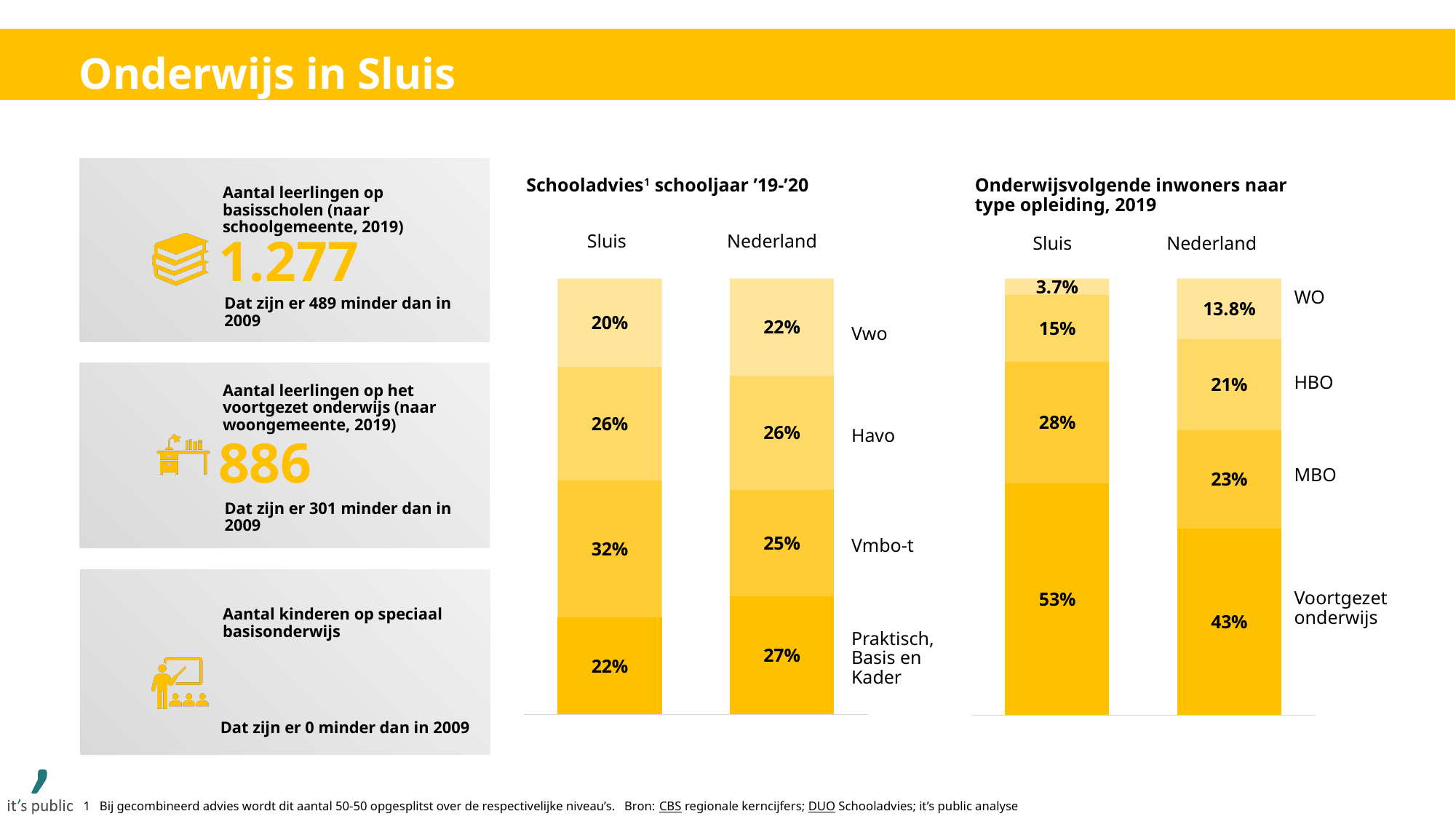
In the 'Onderwijsvolgende inwoners naar type opleiding, 2019' chart, what is the difference between the Voortgezet onderwijs share for Sluis and for Nederland? 10 percentage points What kind of chart is the 'Onderwijsvolgende inwoners naar type opleiding, 2019' chart? Stacked bar chart In the 'Schooladvies schooljaar '19-'20' chart, which segment is the largest in the Sluis bar? Vmbo-t In the 'Onderwijsvolgende inwoners naar type opleiding, 2019' chart, what is the WO share for Sluis? 3.7% In the 'Schooladvies schooljaar '19-'20' chart, what is the Vwo share for Nederland? 22% How many bars does the 'Schooladvies schooljaar '19-'20' chart show? 2 In the 'Onderwijsvolgende inwoners naar type opleiding, 2019' chart, what is the MBO share for Nederland? 23% In the 'Onderwijsvolgende inwoners naar type opleiding, 2019' chart, which segment is the smallest in the Nederland bar? WO In the 'Onderwijsvolgende inwoners naar type opleiding, 2019' chart, which is larger: the HBO share for Sluis or for Nederland? Nederland In the 'Schooladvies schooljaar '19-'20' chart, what is the difference between the Praktisch, Basis en Kader share for Nederland and for Sluis? 5 percentage points In the 'Schooladvies schooljaar '19-'20' chart, what is the Vmbo-t share for Sluis? 32% In the 'Schooladvies schooljaar '19-'20' chart, which is larger: the Havo share for Sluis or for Nederland? They are equal (26%)